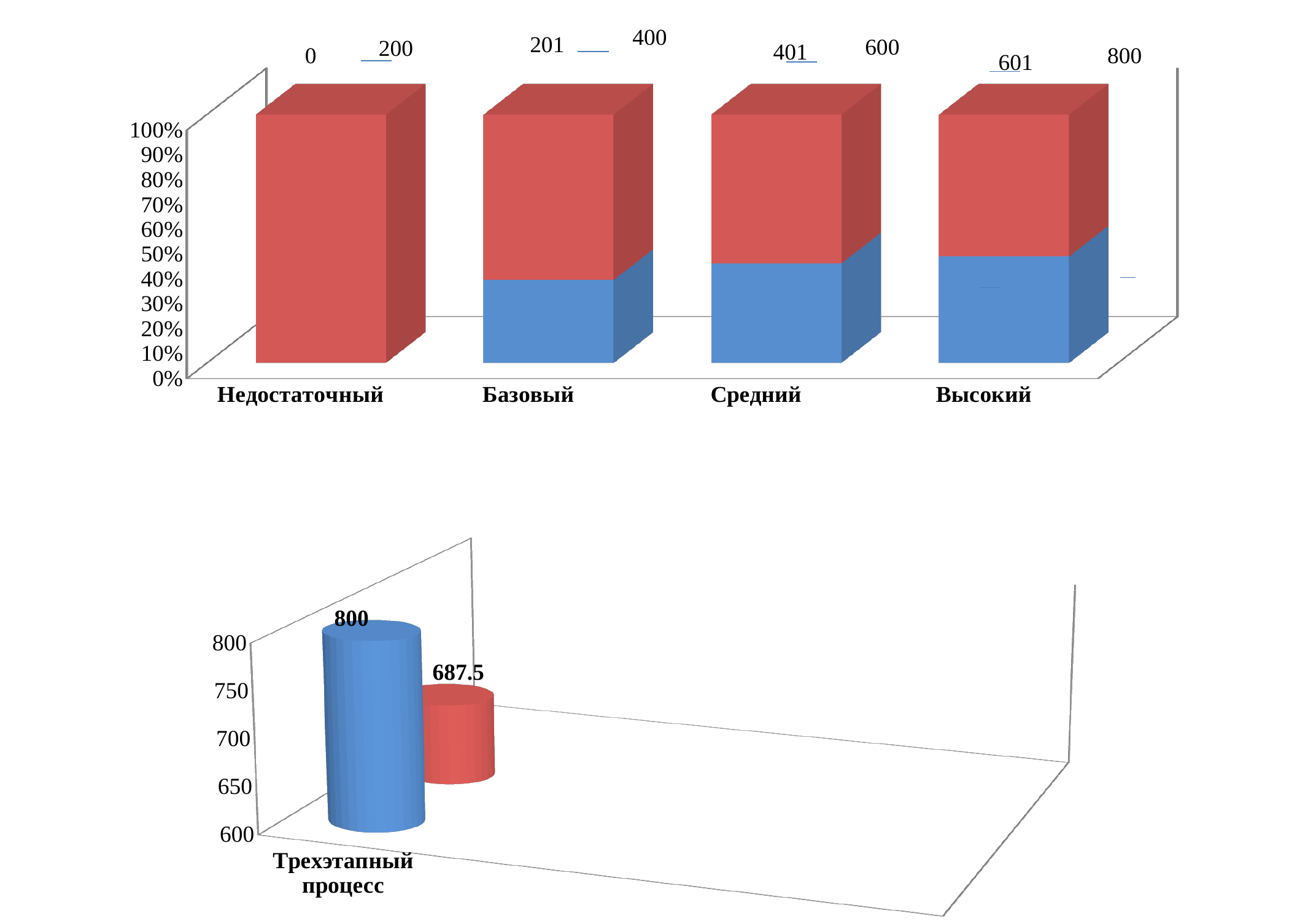
On the top chart, which category has the largest blue segment? Высокий On the bottom chart, which bar is taller, the blue one or the red one? the blue one On the top chart, is the blue segment for Базовый greater or less than 50%? less On the bottom chart, what is the value of the blue bar for Трехэтапный процесс? 800 On the top chart, how many categories are shown on the x axis? 4 On the top chart, which category has no blue segment at all? Недостаточный On the bottom chart, how many categories are shown on the x axis? 1 On the bottom chart, what is the value of the red bar for Трехэтапный процесс? 687.5 What kind of chart is the top chart? stacked bar chart On the bottom chart, what is the difference between the blue bar (800) and the red bar (687.5)? 112.5 What kind of chart is the bottom chart? bar chart On the top chart, does the blue share rise or fall from Недостаточный to Высокий? rise